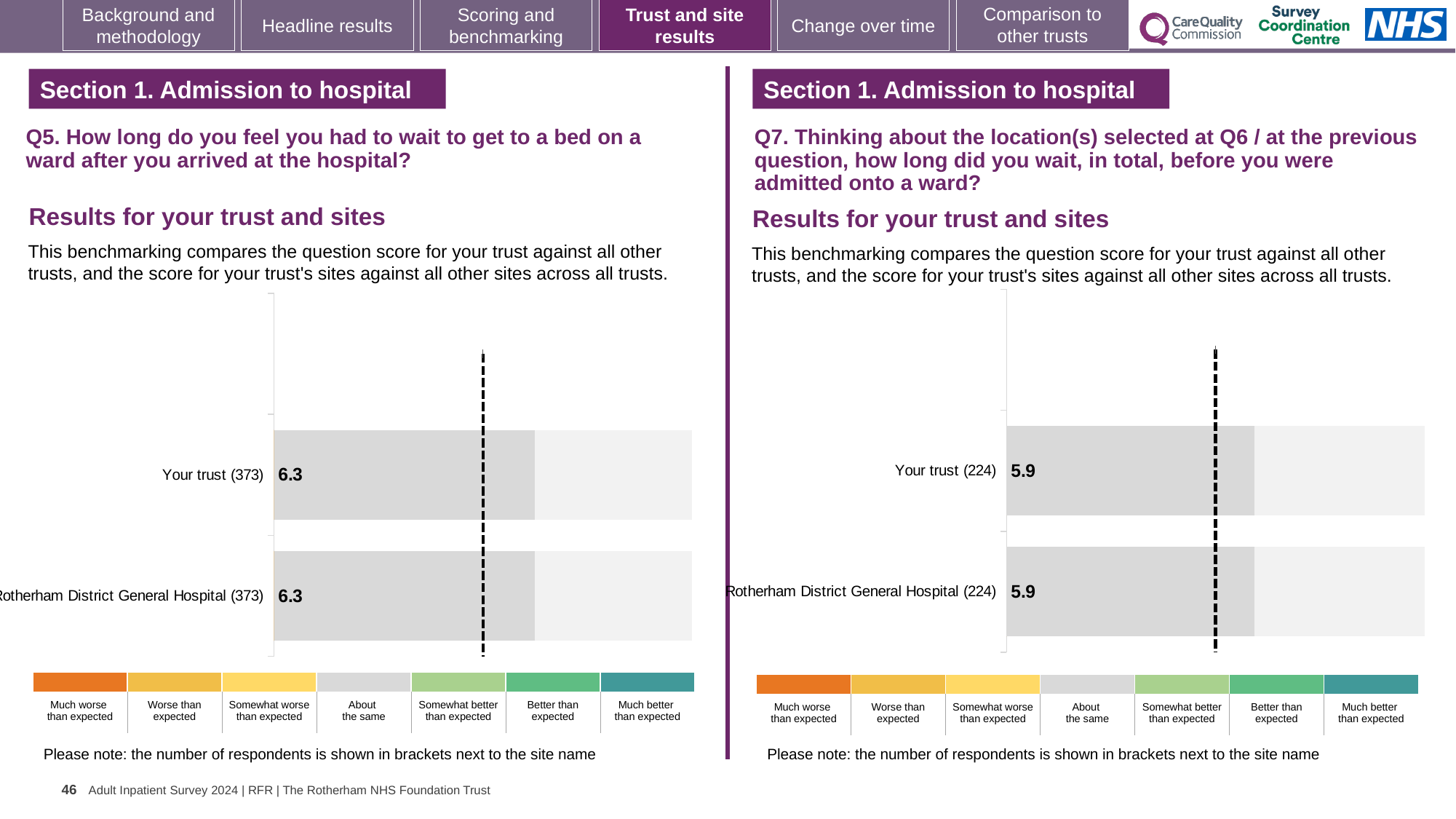
On the Q5 chart (left), what is the score for Your trust? 6.3 On the Q5 chart (left), what is the score for Rotherham District General Hospital? 6.3 On the Q5 chart (left), how many respondents are shown in brackets for Your trust? 373 On the Q7 chart (right), how many respondents are shown in brackets for Rotherham District General Hospital? 224 What kind of chart is the Q5 chart (left)? Bar chart On the Q7 chart (right), what is the difference between the score for Your trust and the score for Rotherham District General Hospital? 0 On the Q7 chart (right), what is the score for Rotherham District General Hospital? 5.9 Is the score for Your trust on the Q5 chart (left) larger or smaller than the score for Your trust on the Q7 chart (right)? Larger On the Q5 chart (left), what is the difference between the score for Your trust and the score for Rotherham District General Hospital? 0 How many bars are plotted on the Q7 chart (right)? 2 How many bars are plotted on the Q5 chart (left)? 2 On the Q7 chart (right), what is the score for Your trust? 5.9